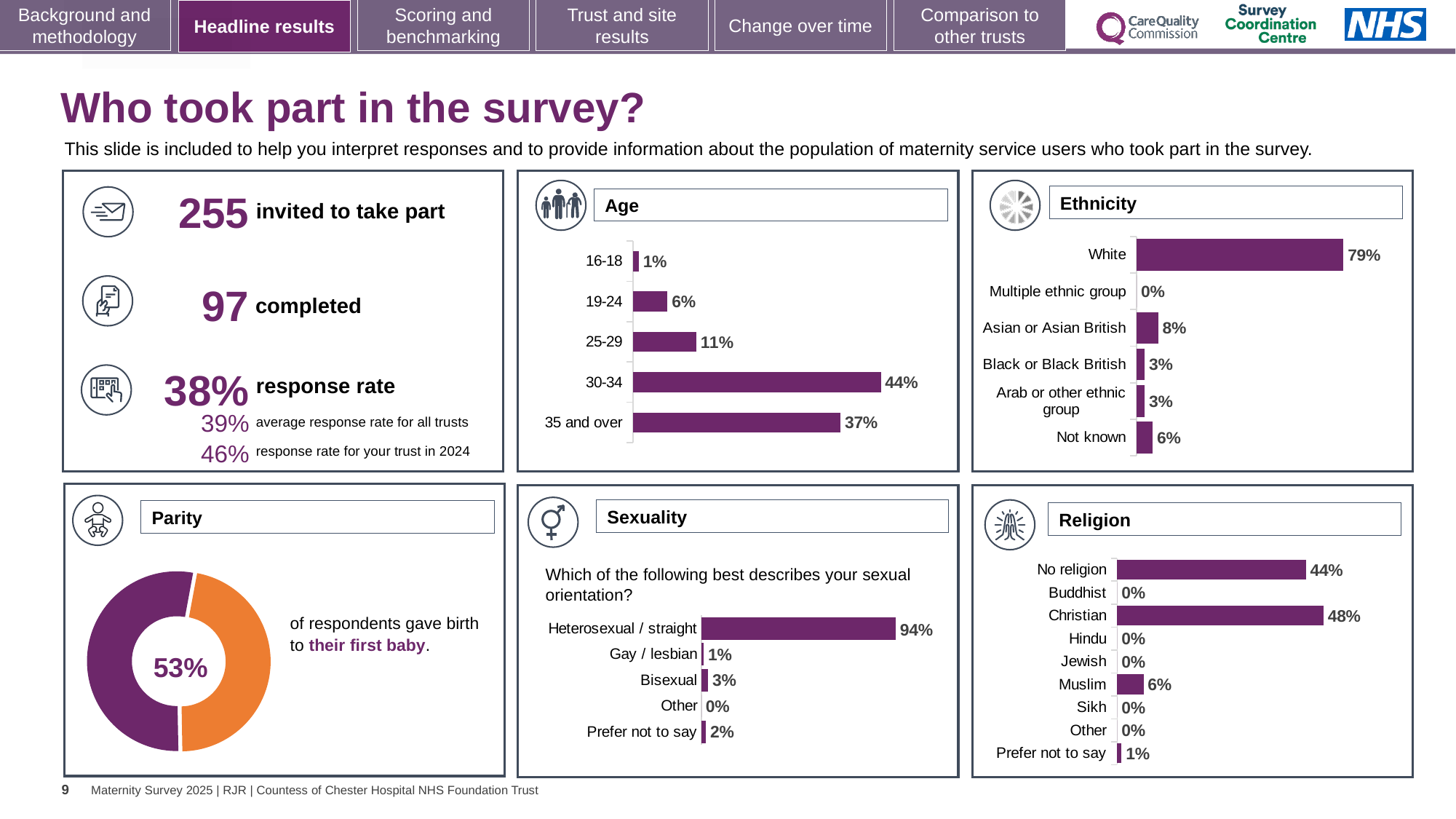
In the Sexuality chart, how many response categories are shown? 5 What kind of chart is the Parity chart? Doughnut chart In the Sexuality chart, what percentage of respondents described themselves as Heterosexual / straight? 94% In the Religion chart, which religion category has the highest percentage? Christian In the Ethnicity chart, which is larger: Asian or Asian British or Not known? Asian or Asian British In the Ethnicity chart, what percentage of respondents were White? 79% In the Age chart, what percentage of respondents were aged 30-34? 44% In the Ethnicity chart, how many ethnicity categories are shown? 6 In the Parity chart, what percentage of respondents gave birth to their first baby? 53% In the Age chart, which age group has the lowest percentage? 16-18 In the Age chart, what is the difference between the 30-34 and 35 and over percentages? 7% In the Religion chart, what percentage of respondents were Muslim? 6%